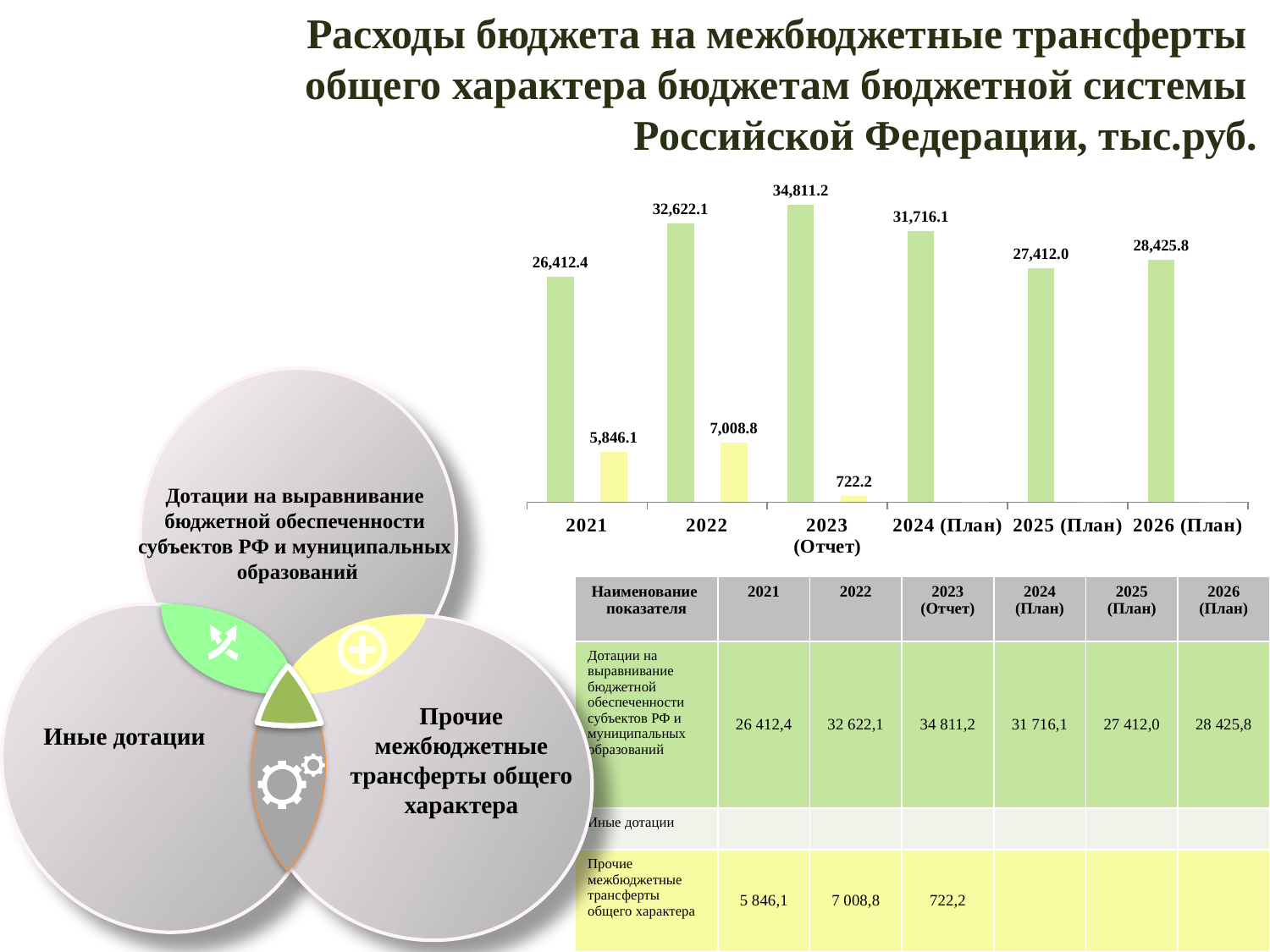
How many year categories are shown on the x axis of the chart? 6 What is the value of the green bar for 2023 (Отчет)? 34,811.2 What is the value of the green bar for 2026 (План)? 28,425.8 What type of chart is shown on the slide? bar chart What is the difference between the green bar values for 2023 (Отчет) and 2024 (План)? 3,095.1 In which year is the green bar the highest? 2023 (Отчет) What is the value of the yellow bar for 2022? 7,008.8 Do the green bar values rise or fall from 2023 (Отчет) to 2025 (План)? fall What is the value of the green bar for 2021? 26,412.4 In which year is the yellow bar the lowest? 2023 (Отчет) In which year is the green bar the lowest? 2021 Which is larger: the green bar for 2025 (План) or the green bar for 2026 (План)? 2026 (План)